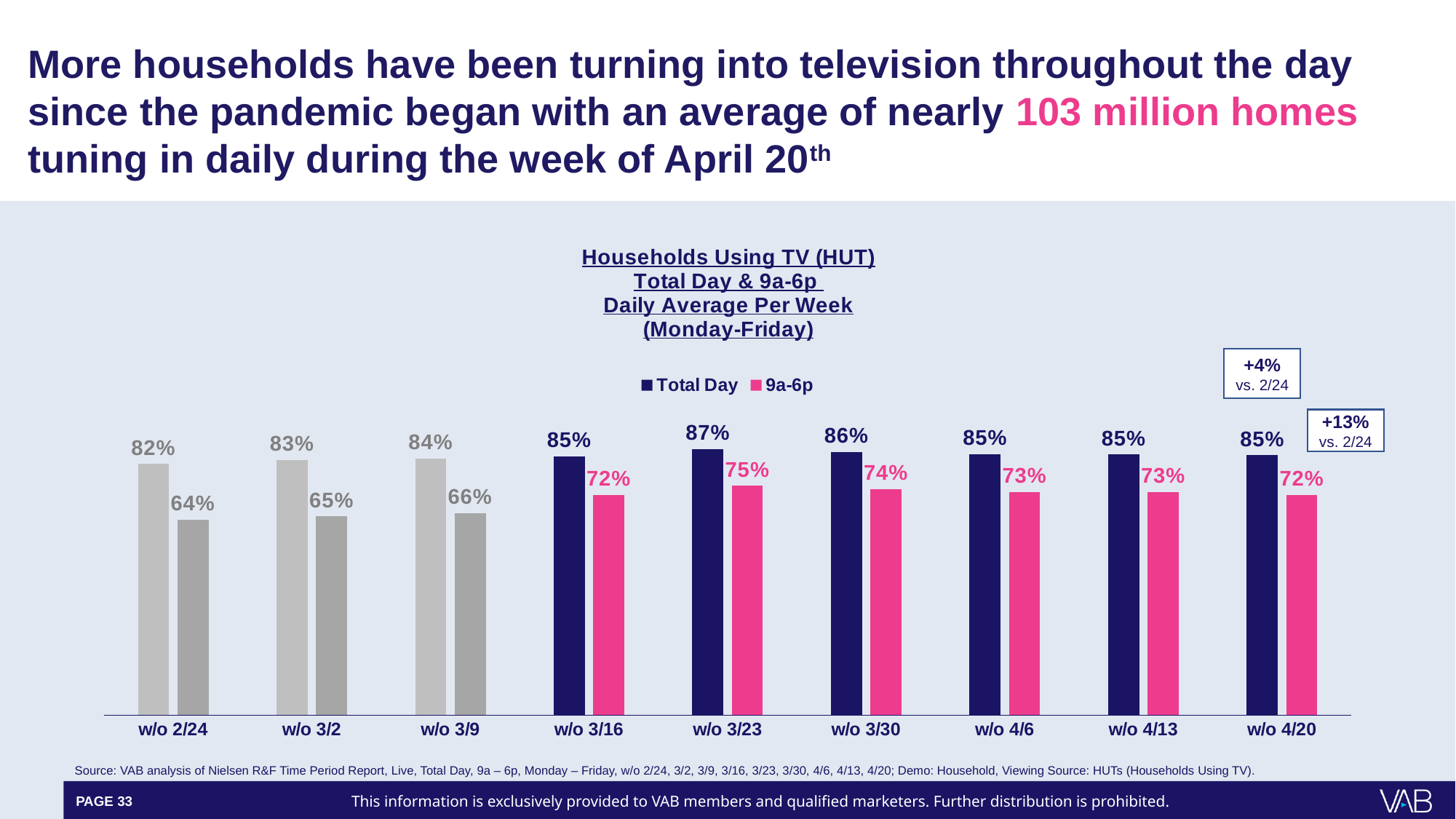
What is the difference between the Total Day and 9a-6p values for w/o 3/16? 13% Which week has the highest Total Day value? w/o 3/23 What kind of chart is shown on the slide? Bar chart How many weeks are shown on the x axis? 9 Which is larger, the 9a-6p value for w/o 3/30 or for w/o 4/6? w/o 3/30 What is the 9a-6p value for w/o 4/20? 72% How many series does the legend list? 2 What is the Total Day value for w/o 3/23? 87% What percentage change vs. 2/24 is shown in the callout for the 9a-6p value for w/o 4/20? +13% Which week has the lowest 9a-6p value? w/o 2/24 What is the 9a-6p value for w/o 2/24? 64% What is the difference between the 9a-6p values for w/o 3/23 and w/o 2/24? 11%